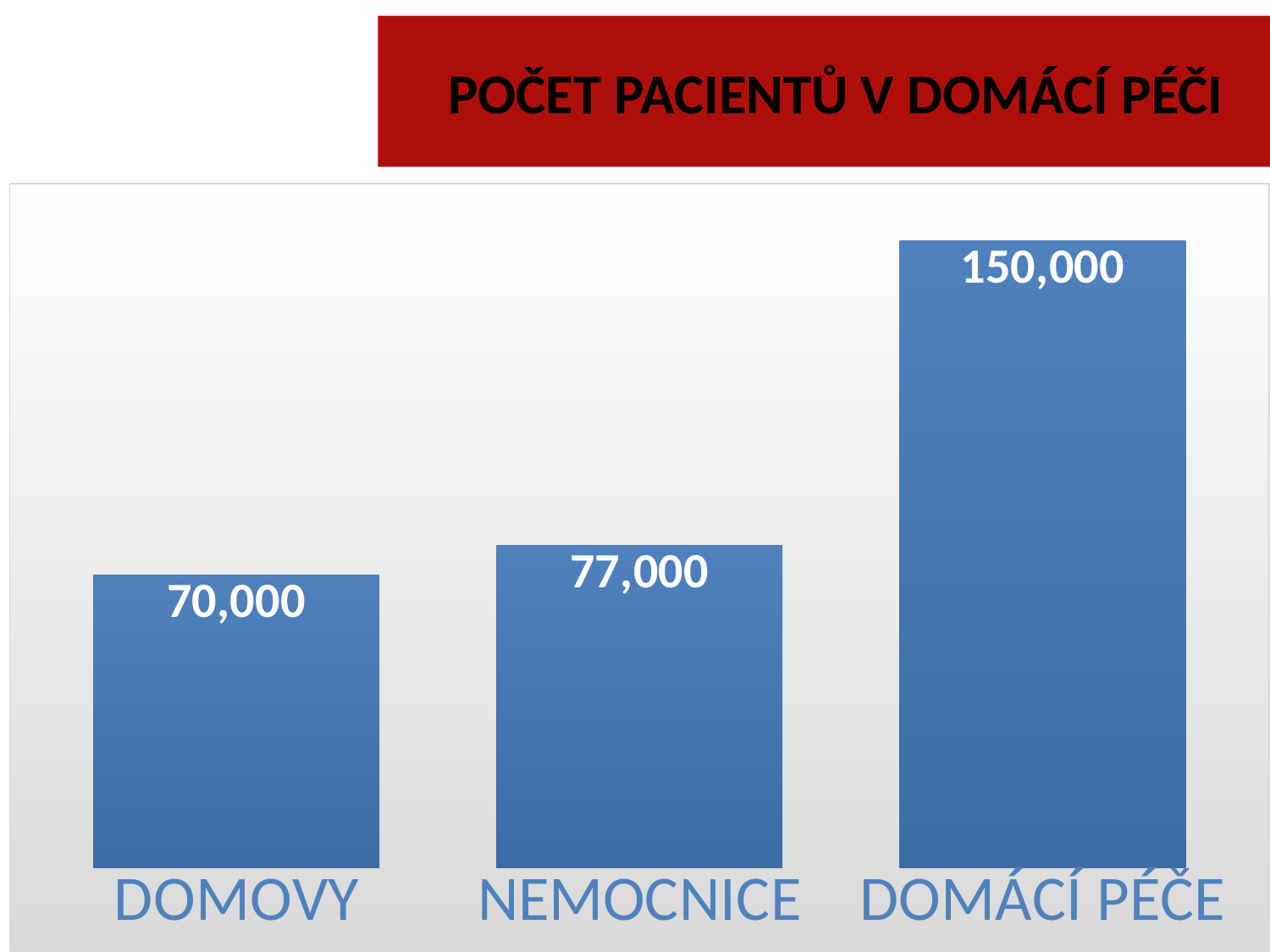
What is the value for DOMOVY? 70,000 How many categories are shown in the chart? 3 Which category has the highest value? DOMÁCÍ PÉČE Which category has the lowest value? DOMOVY What is the value for DOMÁCÍ PÉČE? 150,000 Do the values rise or fall from left to right across the categories? rise What is the difference between the values for NEMOCNICE and DOMOVY? 7,000 What is the value for NEMOCNICE? 77,000 What kind of chart is shown on the slide? bar chart What is the difference between the values for DOMÁCÍ PÉČE and NEMOCNICE? 73,000 Which is larger, the value for DOMOVY or the value for DOMÁCÍ PÉČE? DOMÁCÍ PÉČE What is the title of the chart? POČET PACIENTŮ V DOMÁCÍ PÉČI